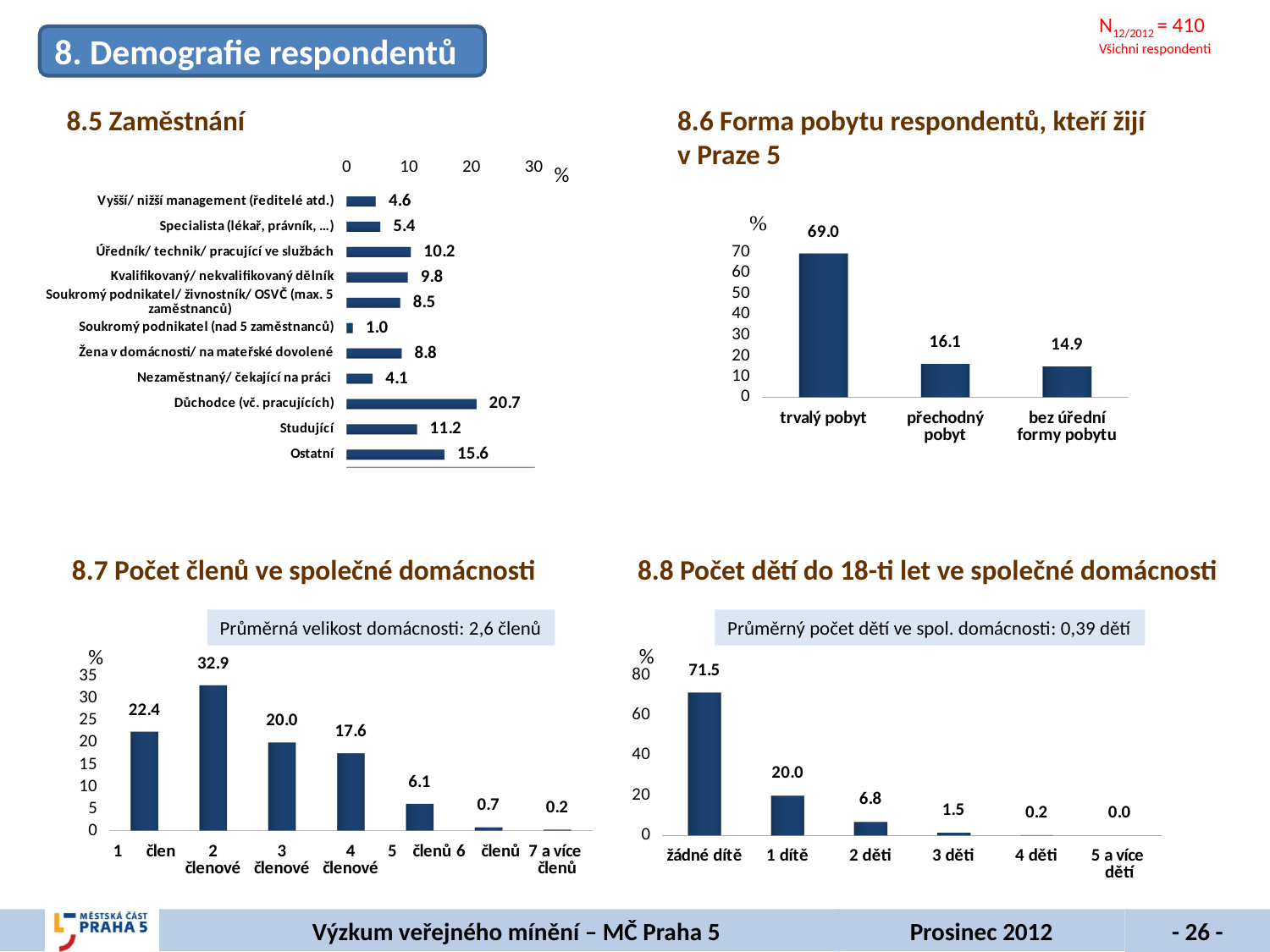
In the chart '8.6 Forma pobytu respondentů, kteří žijí v Praze 5', what is the difference between 'přechodný pobyt' and 'bez úřední formy pobytu'? 1.2 In the chart '8.7 Počet členů ve společné domácnosti', which is larger: the value for '1 člen' or the value for '3 členové'? 1 člen In the chart '8.5 Zaměstnání', which category has the lowest value? Soukromý podnikatel (nad 5 zaměstnanců) In the chart '8.5 Zaměstnání', what is the value for 'Důchodce (vč. pracujících)'? 20.7 In the chart '8.7 Počet členů ve společné domácnosti', which category has the highest value? 2 členové In the chart '8.8 Počet dětí do 18-ti let ve společné domácnosti', what is the value for '2 děti'? 6.8 In the chart '8.8 Počet dětí do 18-ti let ve společné domácnosti', do the values rise or fall from left to right along the x axis? fall What kind of chart is '8.5 Zaměstnání'? bar chart In the chart '8.5 Zaměstnání', how many categories are shown? 11 What average household size is stated in the text box of the chart '8.7 Počet členů ve společné domácnosti'? 2,6 členů In the chart '8.6 Forma pobytu respondentů, kteří žijí v Praze 5', what is the value for 'trvalý pobyt'? 69.0 In the chart '8.7 Počet členů ve společné domácnosti', what is the value for '4 členové'? 17.6